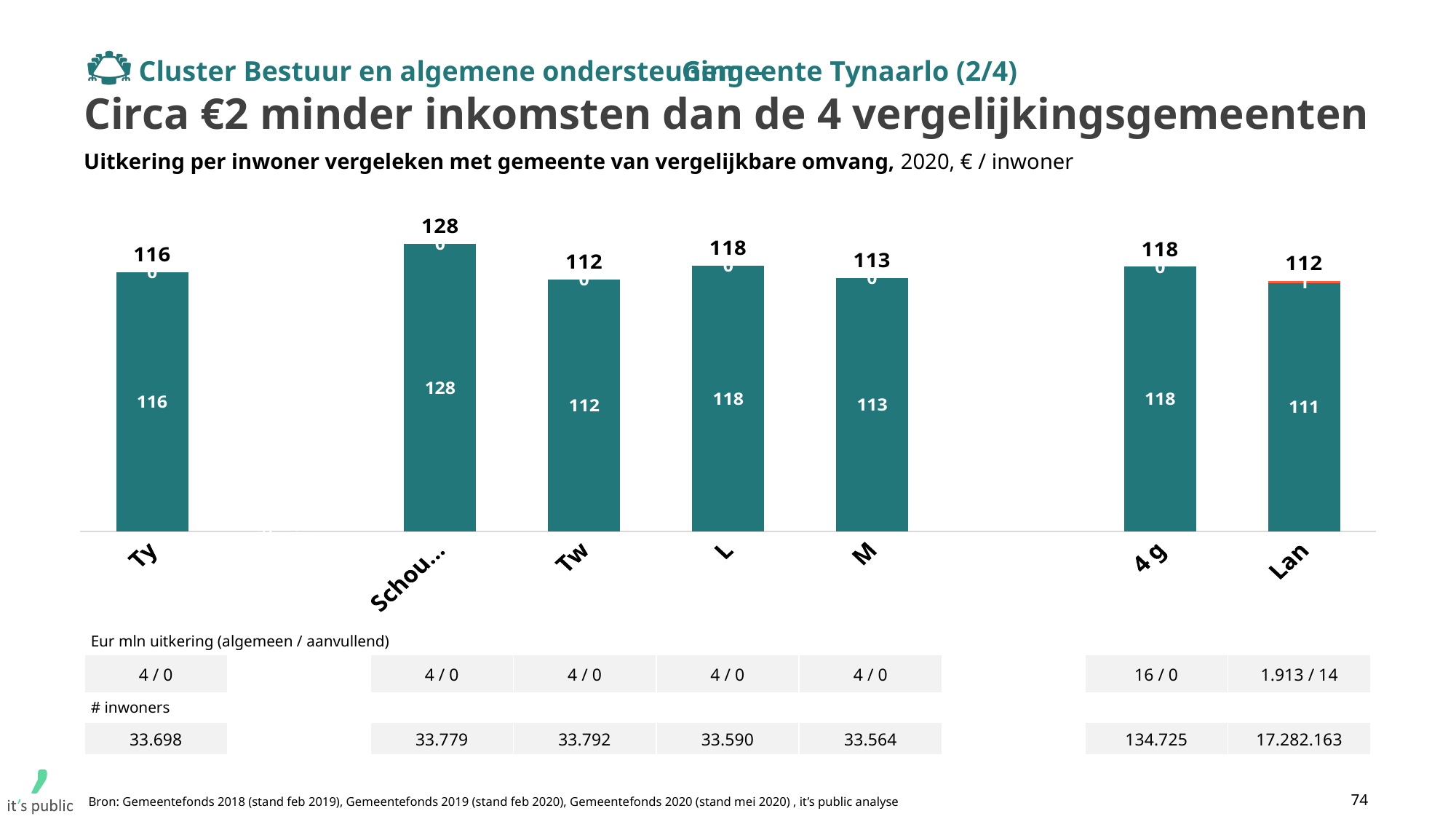
What is the value shown above the bar for M? 113 What is the difference between the values for Schou… and Ty? 12 What is the value of the teal segment of the bar for Lan? 111 What is the value shown above the bar for 4 g? 118 How many bars are plotted in the chart? 7 What type of chart is shown on the slide? bar chart Which category has the highest bar? Schou… Which is larger, the value for Ty or the value for M? Ty What is the value shown above the bar for Ty? 116 What is the value shown above the bar for L? 118 In what unit are the values in the chart expressed, according to the subtitle? € / inwoner What is the difference between the values for 4 g and Ty? 2